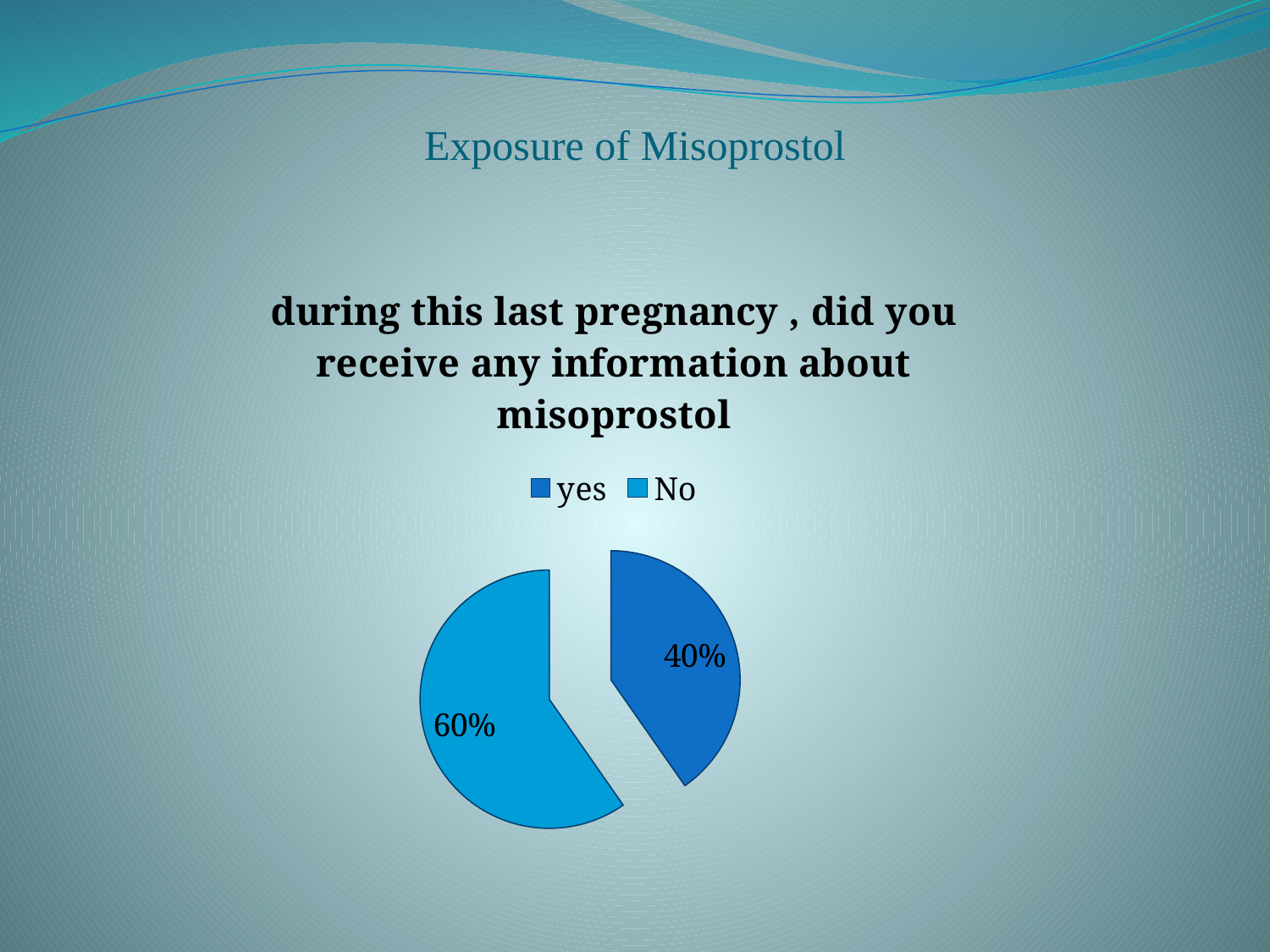
What percentage of respondents answered 'yes'? 40% Which is larger, the 'yes' slice or the 'No' slice? No How many slices does the pie chart have? 2 What is the difference in percentage points between the 'No' and 'yes' slices? 20% What is the title of the chart? during this last pregnancy , did you receive any information about misoprostol Which response has the largest share of the pie? No How many entries does the legend list? 2 Is the share for 'yes' greater or less than 50%? less What type of chart is shown on the slide? pie chart Which legend entry is shown in the lighter blue colour? No Which response has the smallest share of the pie? yes What percentage of respondents answered 'No'? 60%